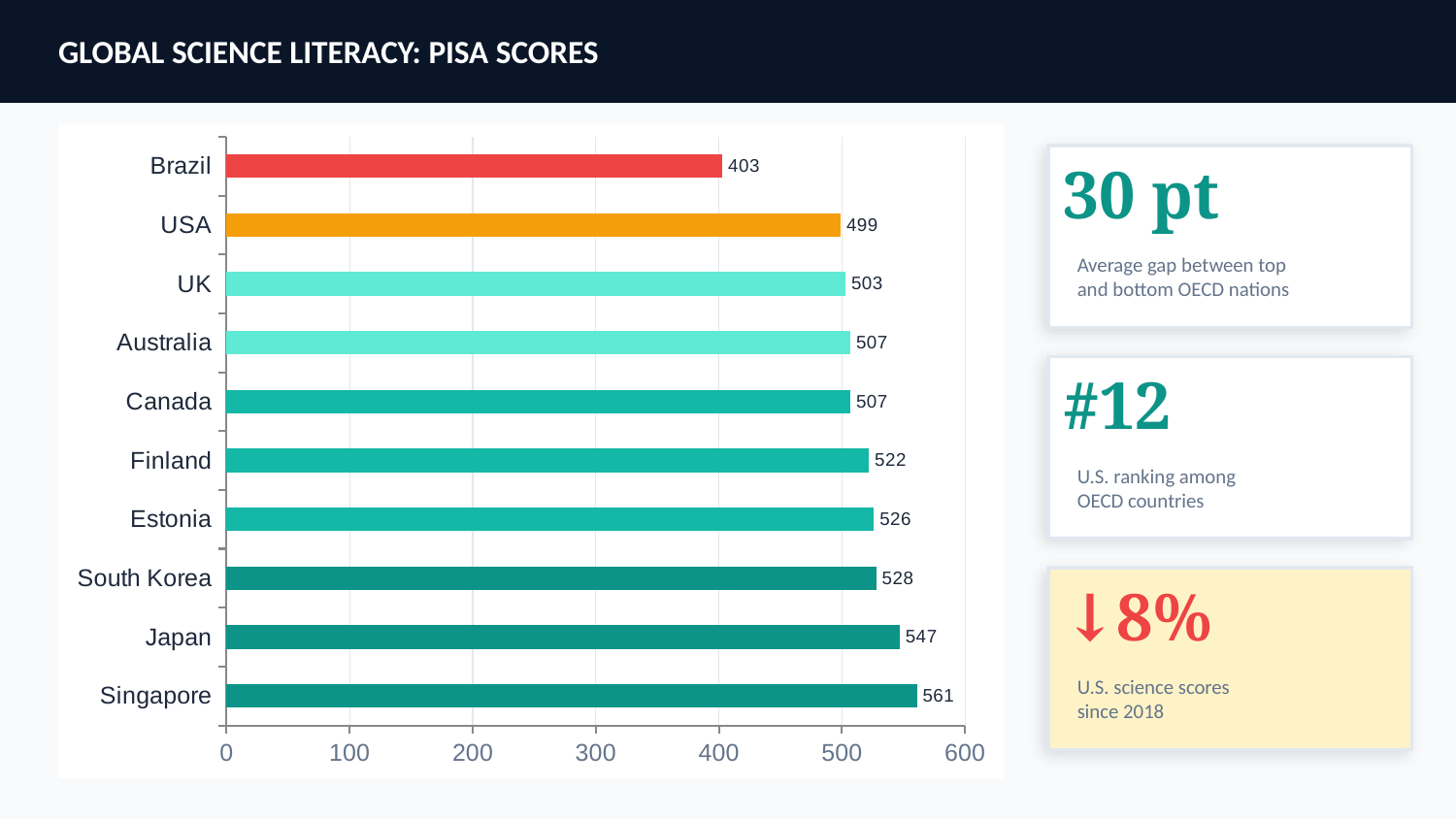
What kind of chart is shown on the slide? Bar chart What is the difference between Singapore's and Brazil's PISA science scores? 158 What is the PISA science score for Singapore? 561 How many countries are shown in the chart? 10 Which country has the highest PISA science score? Singapore Is the value for Brazil greater or less than 500? less What is the difference between Japan's and South Korea's PISA science scores? 19 Which country has the lowest PISA science score? Brazil Which has a higher PISA science score, the UK or the USA? UK Which two countries share the same PISA science score of 507? Australia and Canada What is the PISA science score for the USA? 499 What is the PISA science score for Finland? 522